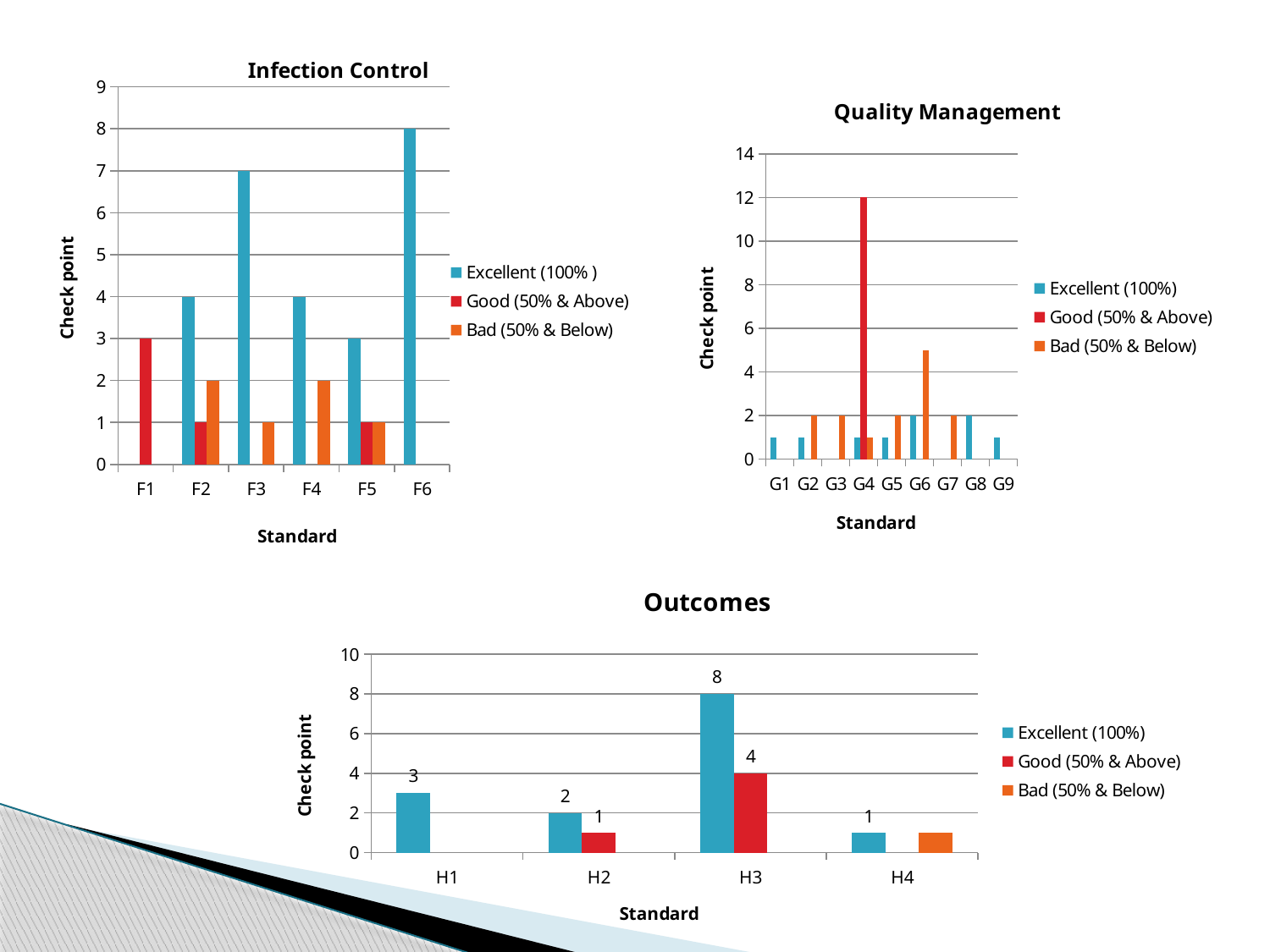
In the Outcomes chart, what is the Excellent (100%) value for H3? 8 In the Infection Control chart, what is the Good (50% & Above) value for F1? 3 In the Quality Management chart, is the Bad (50% & Below) value for G6 greater or less than 4? greater How many standards are shown on the x axis of the Infection Control chart? 6 In the Outcomes chart, what is the difference between the Excellent (100%) and Good (50% & Above) values for H3? 4 How many standards are shown on the x axis of the Quality Management chart? 9 In the Infection Control chart, what is the difference between the Excellent (100%) values for F3 and F2? 3 In the Infection Control chart, what is the Excellent (100%) value for F6? 8 In the Quality Management chart, what is the Good (50% & Above) value for G4? 12 In the Outcomes chart, which is larger: the Excellent (100%) value for H1 or for H2? H1 In the Infection Control chart, which standard has the highest Excellent (100%) value? F6 How many series does the legend of the Outcomes chart list? 3